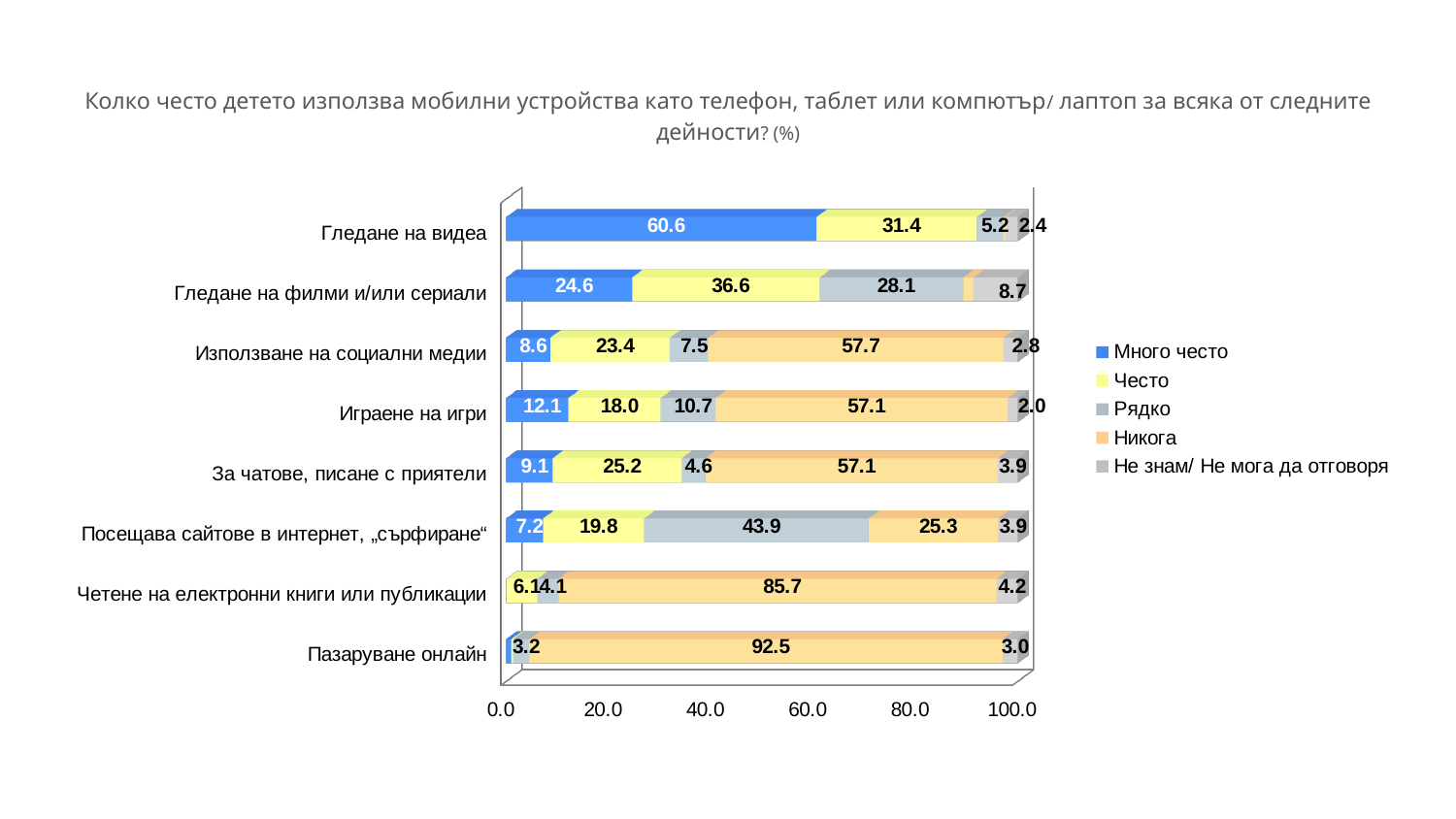
Which activity has the highest "Много често" value? Гледане на видеа What is the value of "Никога" for "Пазаруване онлайн"? 92.5 Which activity has the highest "Никога" value? Пазаруване онлайн Which legend entry is shown in blue? Много често What is the value of "Много често" for "Гледане на видеа"? 60.6 What is the value of "Рядко" for "Посещава сайтове в интернет, „сърфиране“"? 43.9 Which is larger: the "Често" value for "За чатове, писане с приятели" or for "Играене на игри"? За чатове, писане с приятели How many activity categories are plotted on the chart? 8 What is the value of "Често" for "Гледане на филми и/или сериали"? 36.6 What type of chart is shown on the slide? Stacked bar chart How many series does the legend list? 5 What is the difference between the "Никога" values for "Четене на електронни книги или публикации" and "Използване на социални медии"? 28.0